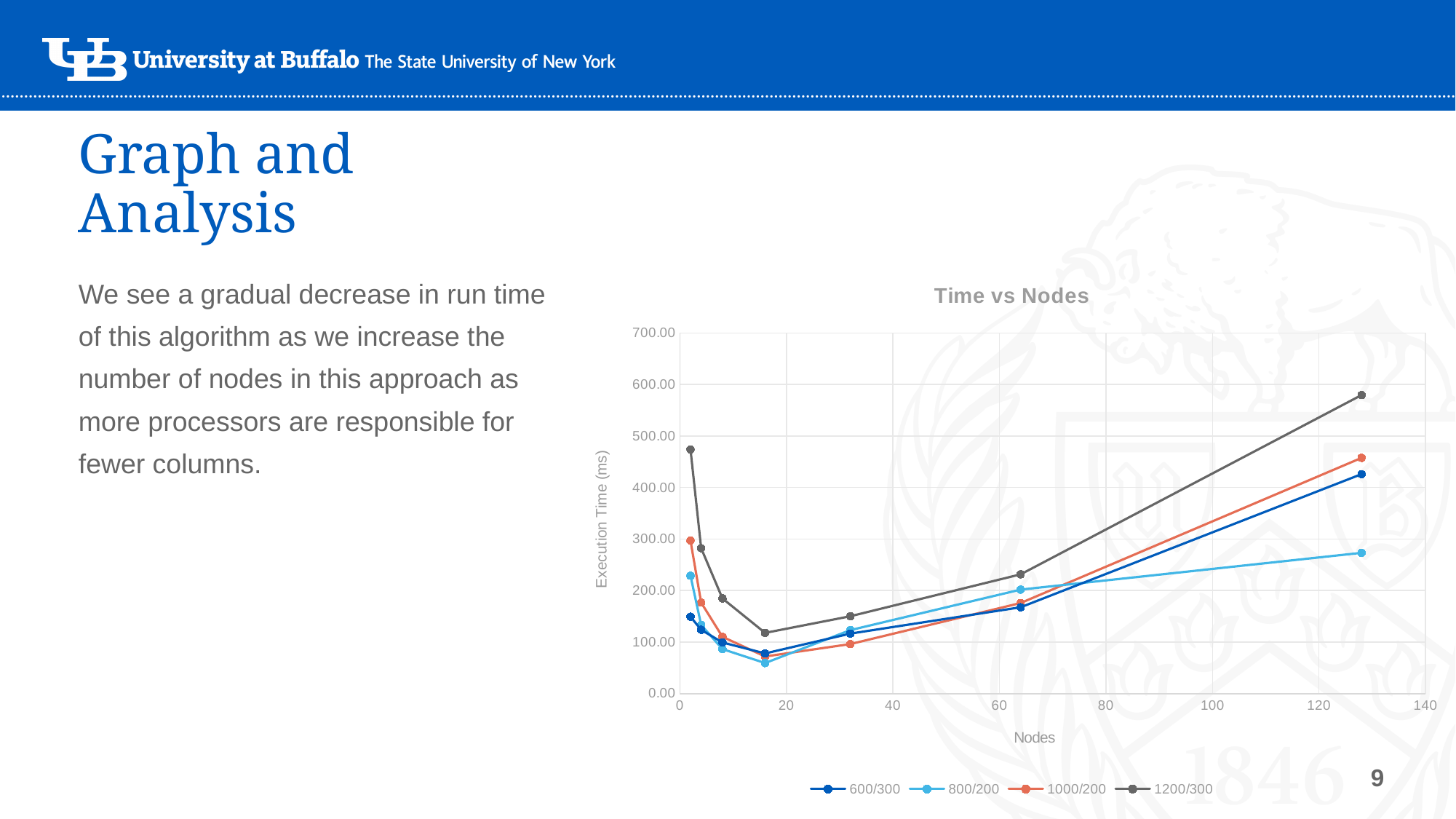
Does the execution time for the 1200/300 series rise or fall as nodes increase from 16 to 128? rise Is the execution time for the 800/200 series at 128 nodes greater or less than 300.00? less How many data points are plotted for each series? 7 Is the execution time for the 1200/300 series at 128 nodes greater or less than 500.00? greater What kind of chart is shown on the slide? line chart Is the execution time for the 1200/300 series at its first (smallest) node count greater or less than 400.00? greater How many series does the legend of the chart list? 4 What is the label of the vertical axis of the chart? Execution Time (ms) What is the title of the chart? Time vs Nodes Which series has the lowest execution time at 128 nodes? 800/200 At 128 nodes, which series has the higher execution time, 1000/200 or 600/300? 1000/200 Which series has the highest execution time at 128 nodes? 1200/300